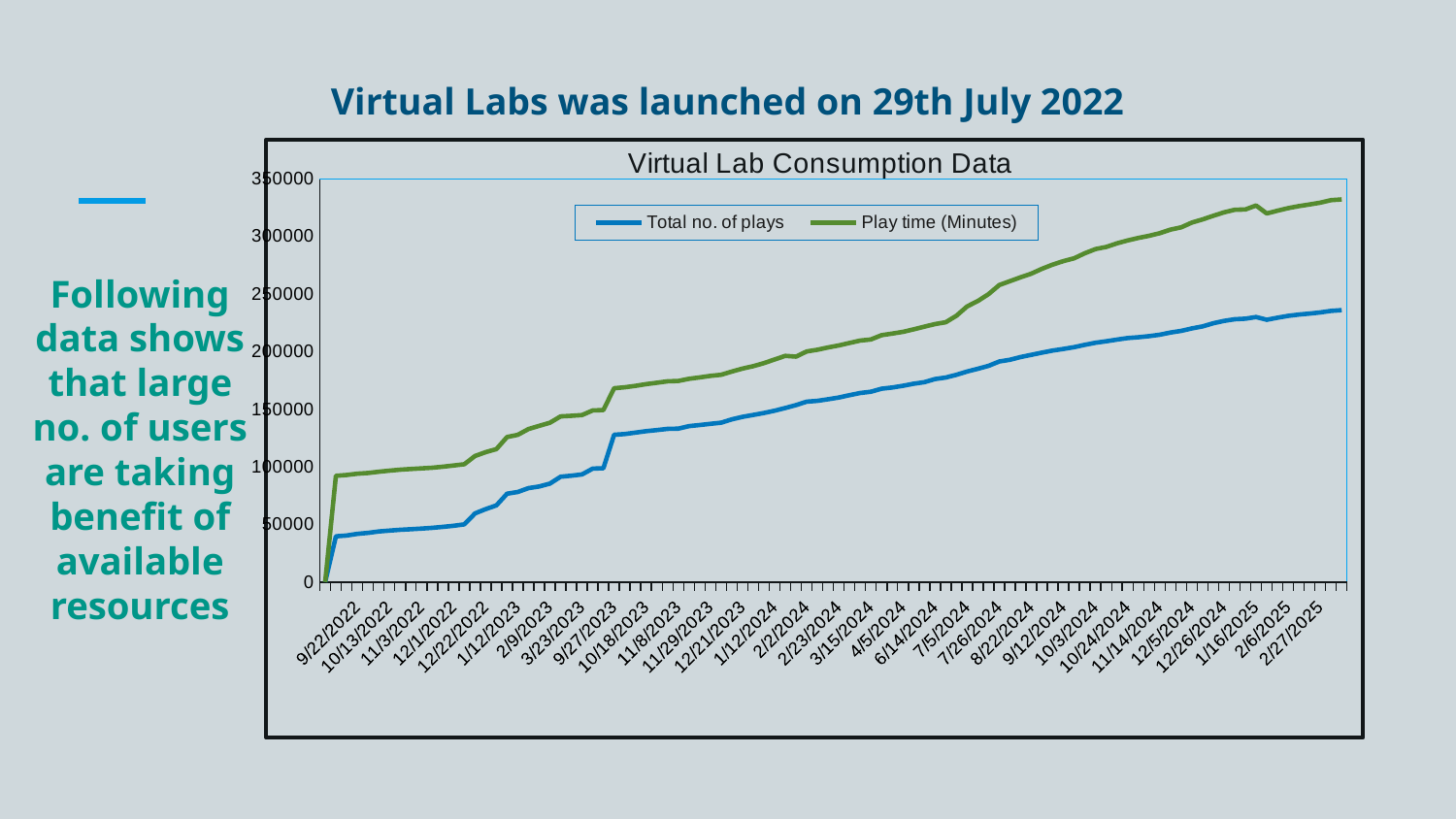
What is the title of the chart? Virtual Lab Consumption Data At 2/27/2025, which series has the larger value, 'Total no. of plays' or 'Play time (Minutes)'? Play time (Minutes) What type of chart is shown on the slide? line chart Is the value for 'Total no. of plays' at 2/27/2025 greater or less than 250000? less Which colour is used for the 'Play time (Minutes)' series? green Is the value for 'Total no. of plays' at 2/27/2025 greater or less than 200000? greater Is the value for 'Play time (Minutes)' at 7/26/2024 greater or less than 250000? greater Do the values for 'Total no. of plays' rise or fall along the x axis? rise How many series does the legend of the chart list? 2 Do the values for 'Play time (Minutes)' generally rise or fall from 9/22/2022 to 2/27/2025? rise